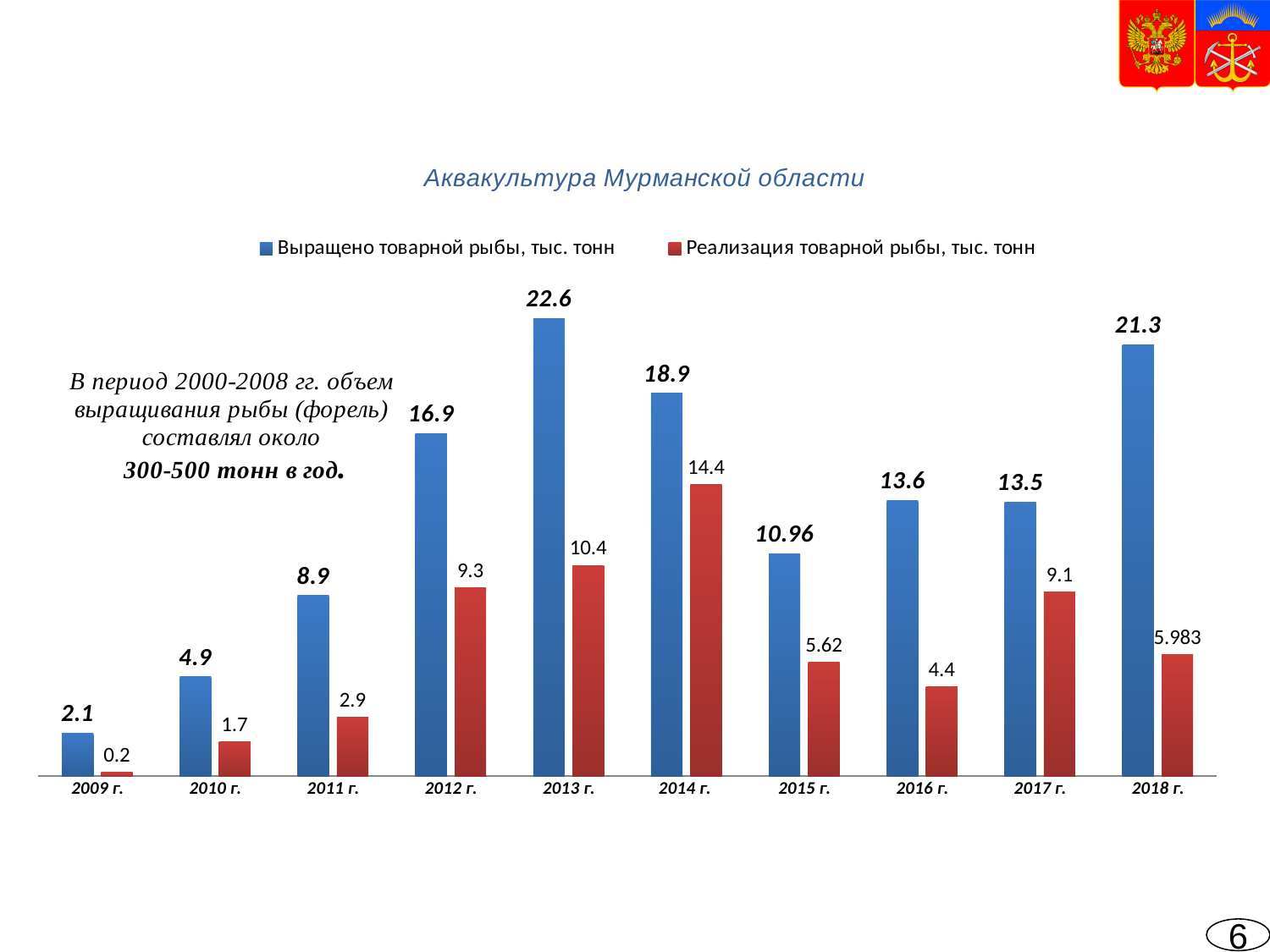
How many years are shown on the x axis of the chart? 10 Does 'Выращено товарной рыбы' rise or fall from 2009 г. to 2013 г.? Rise What is the value of 'Реализация товарной рыбы, тыс. тонн' for 2015 г.? 5.62 Which year has the lowest value for 'Реализация товарной рыбы, тыс. тонн'? 2009 г. What is the value of 'Реализация товарной рыбы, тыс. тонн' for 2018 г.? 5.983 What kind of chart is shown on the slide? Bar chart What is the title of the chart? Аквакультура Мурманской области What is the difference between 'Выращено товарной рыбы' and 'Реализация товарной рыбы' in 2014 г.? 4.5 Which year has the highest value for 'Выращено товарной рыбы, тыс. тонн'? 2013 г. How many series does the legend list? 2 Which is larger: 'Реализация товарной рыбы' in 2017 г. or in 2016 г.? 2017 г. What is the value of 'Выращено товарной рыбы, тыс. тонн' for 2013 г.? 22.6